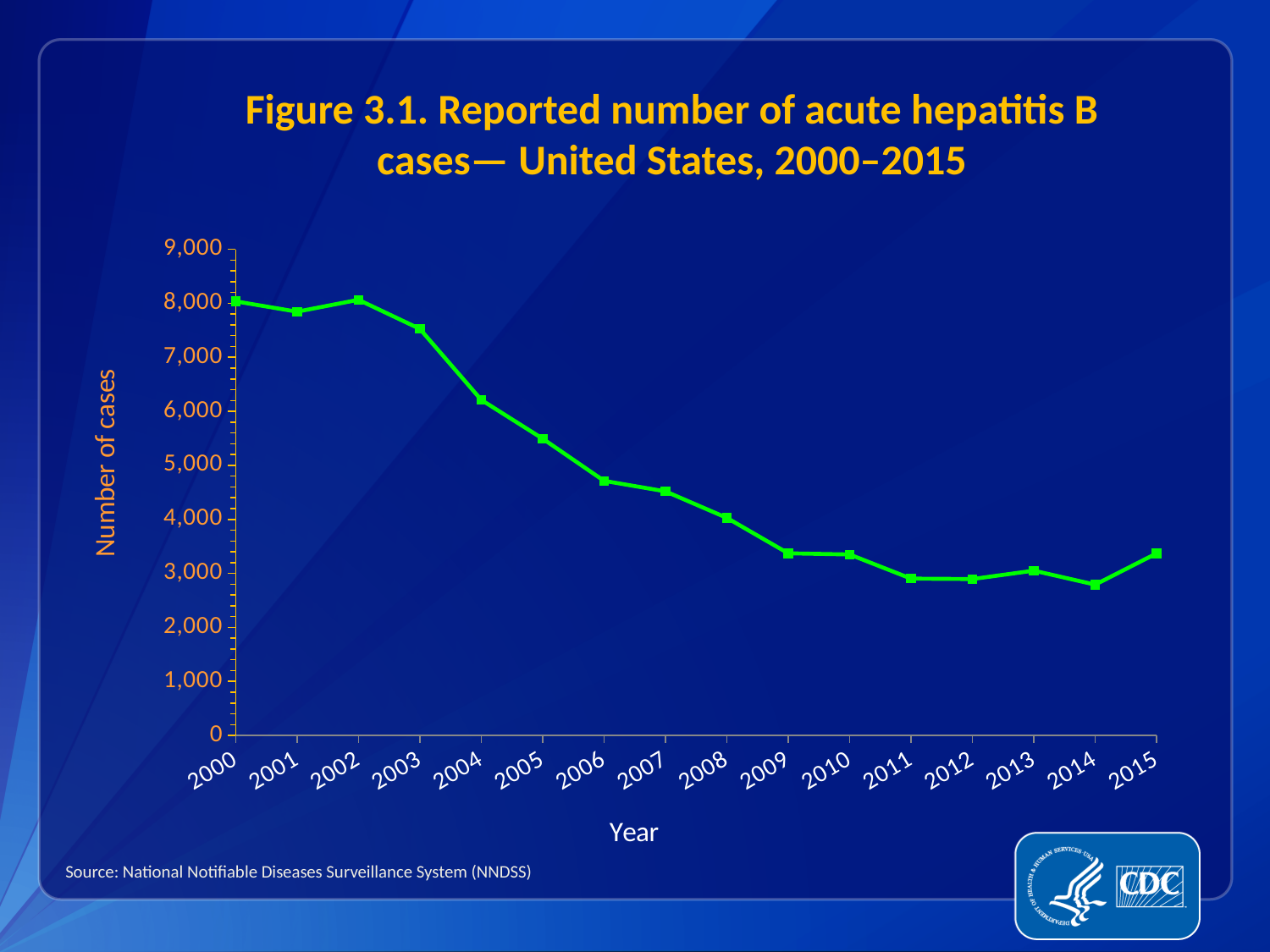
Is the number of cases for 2003 greater or less than 7,000? greater Is the number of cases for 2004 greater or less than 6,000? greater Is the number of cases for 2015 greater or less than 3,000? greater How many years are plotted on the x axis? 16 What kind of chart is shown on the slide? line chart What is the label of the y axis? Number of cases Overall, do the reported acute hepatitis B cases rise or fall from 2000 to 2015? fall Which year has more reported cases, 2003 or 2006? 2003 What is the title of the chart? Figure 3.1. Reported number of acute hepatitis B cases— United States, 2000–2015 Which year has more reported cases, 2014 or 2015? 2015